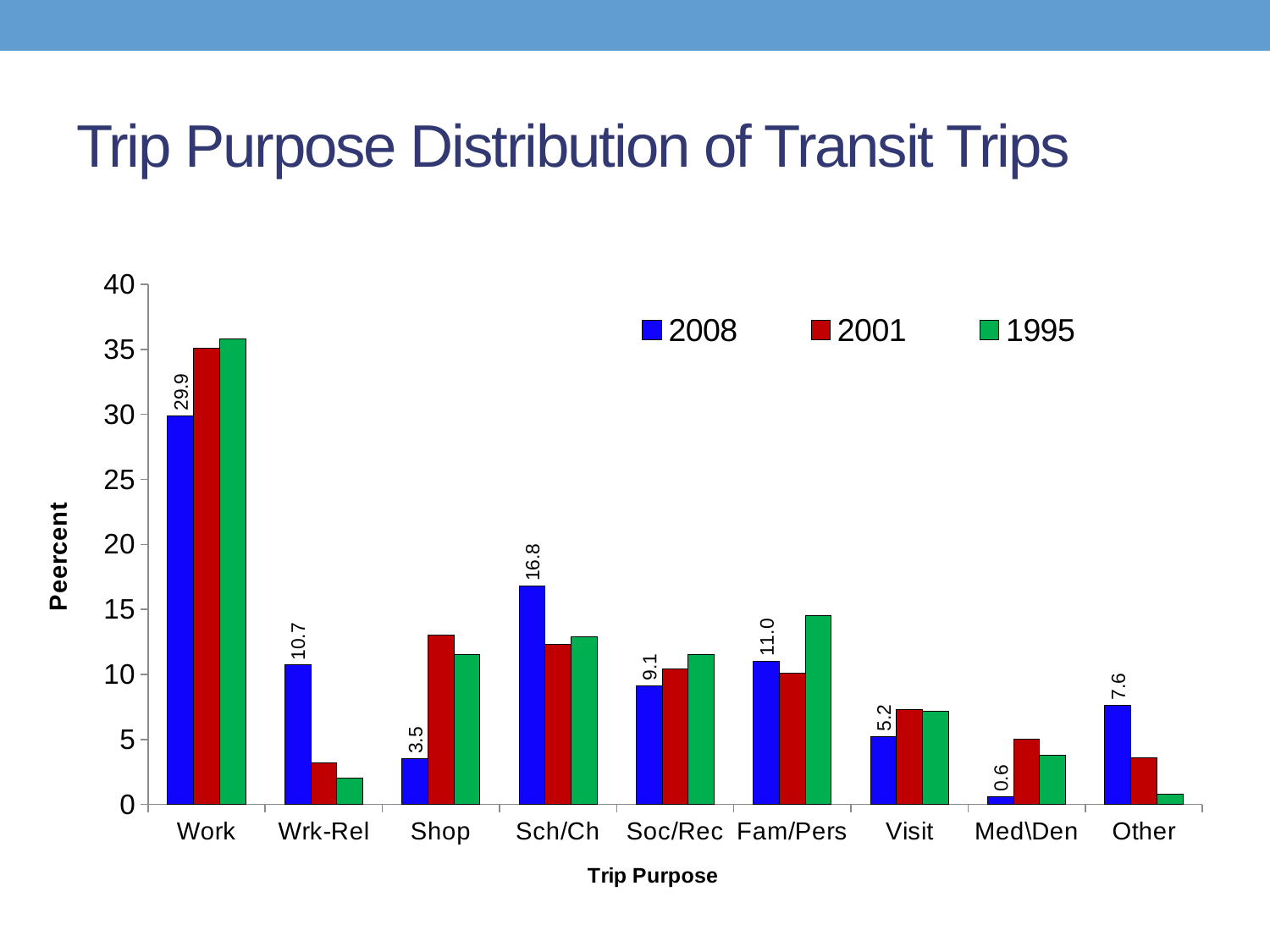
What is the 2008 value for Med\Den? 0.6 What is the 2008 value for Sch/Ch? 16.8 What kind of chart is shown on the slide? Bar chart What is the 2008 value for Work? 29.9 Is the 1995 value for Work greater or less than 30? greater How many series does the legend list? 3 Which trip purpose has the lowest 2008 value? Med\Den Which trip purpose has the highest 2008 value? Work How many trip purpose categories are shown on the x axis? 9 Is the 2001 value for Shop greater or less than 10? greater Which is larger for 2008: Wrk-Rel or Fam/Pers? Fam/Pers What is the difference between the 2008 values for Work and Sch/Ch? 13.1